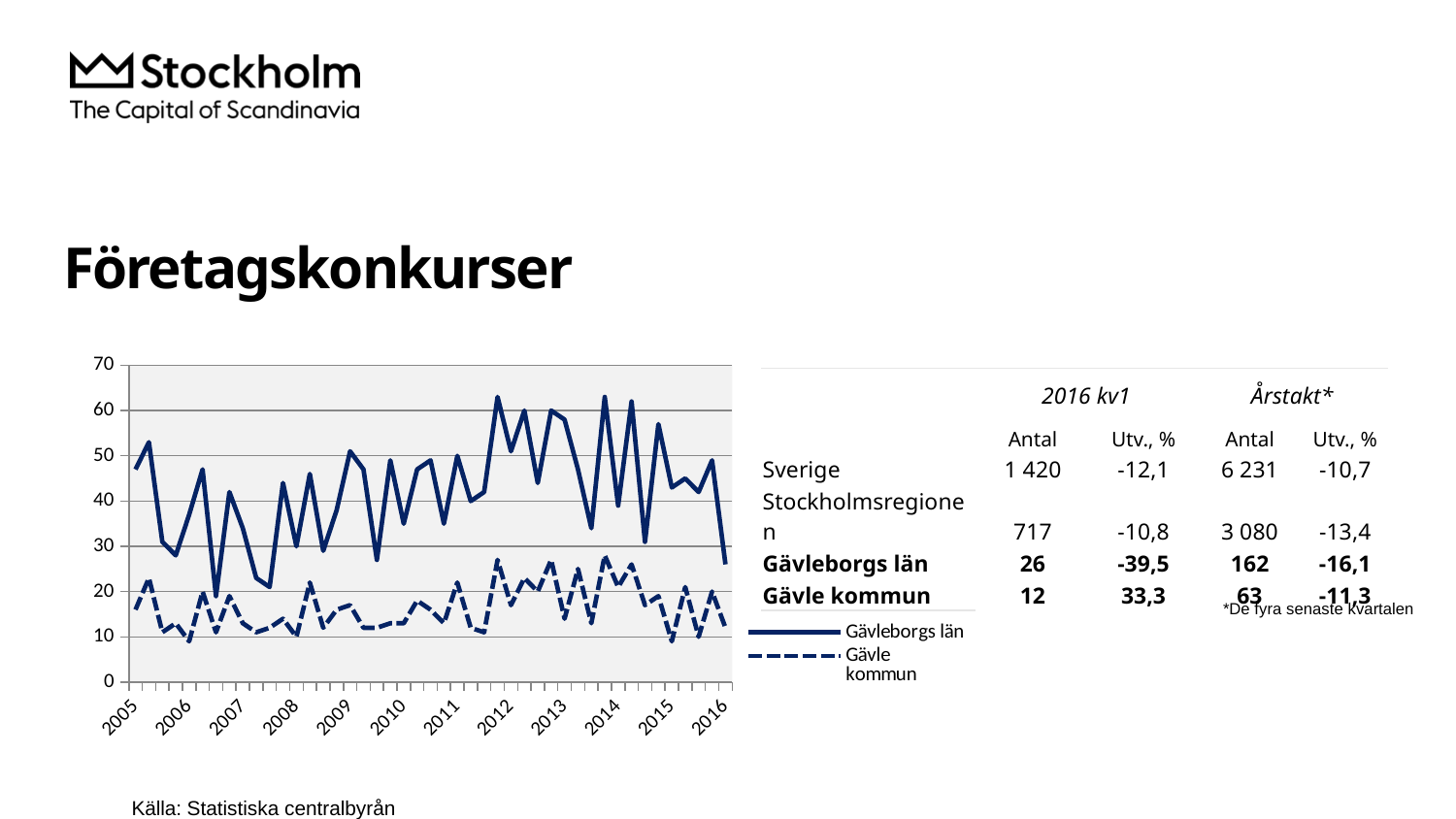
What kind of chart is shown on the slide? line chart Is the highest value reached by Gävle kommun greater or less than 30? less Which series in the chart is drawn with a dashed line? Gävle kommun Is the highest value reached by Gävleborgs län greater or less than 60? greater How many series does the chart's legend list? 2 Is the last value for Gävleborgs län in 2016 greater or less than 40? less How many year labels are shown on the x axis of the chart? 12 What is the highest value shown on the chart's y axis? 70 Which series has higher values throughout the chart, Gävleborgs län or Gävle kommun? Gävleborgs län Which two series are listed in the chart's legend? Gävleborgs län and Gävle kommun